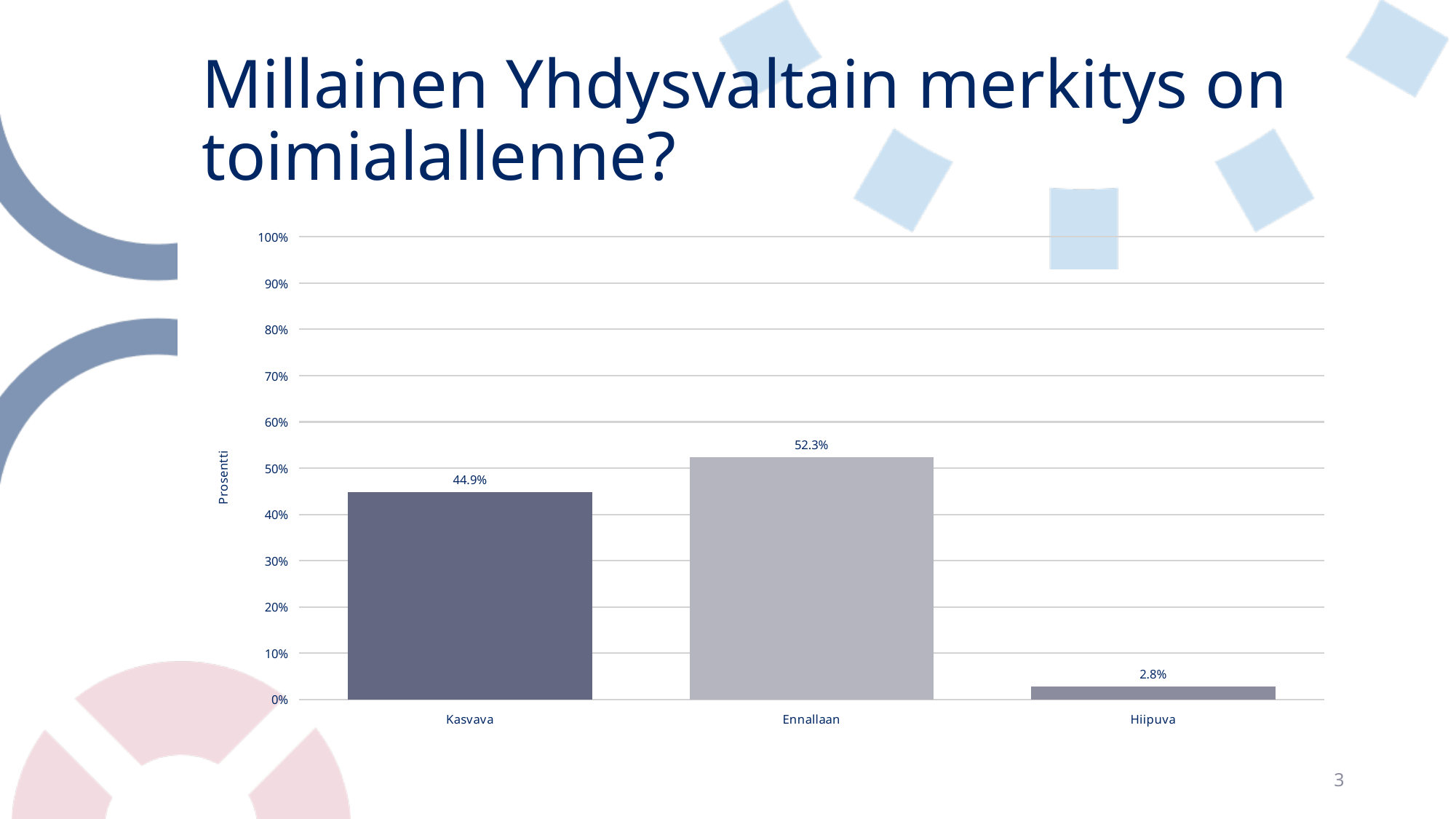
What is the value for Kasvava? 44.9% Is the value for Kasvava greater or less than 50%? less What is the value for Hiipuva? 2.8% What is the value for Ennallaan? 52.3% What is the difference between the values for Kasvava and Hiipuva? 42.1% Which category has the lowest value? Hiipuva Which is larger, the value for Kasvava or the value for Ennallaan? Ennallaan What is the label of the vertical axis? Prosentti What kind of chart is shown on the slide? bar chart Which category has the highest value? Ennallaan How many categories are shown on the x axis? 3 What is the difference between the values for Ennallaan and Kasvava? 7.4%